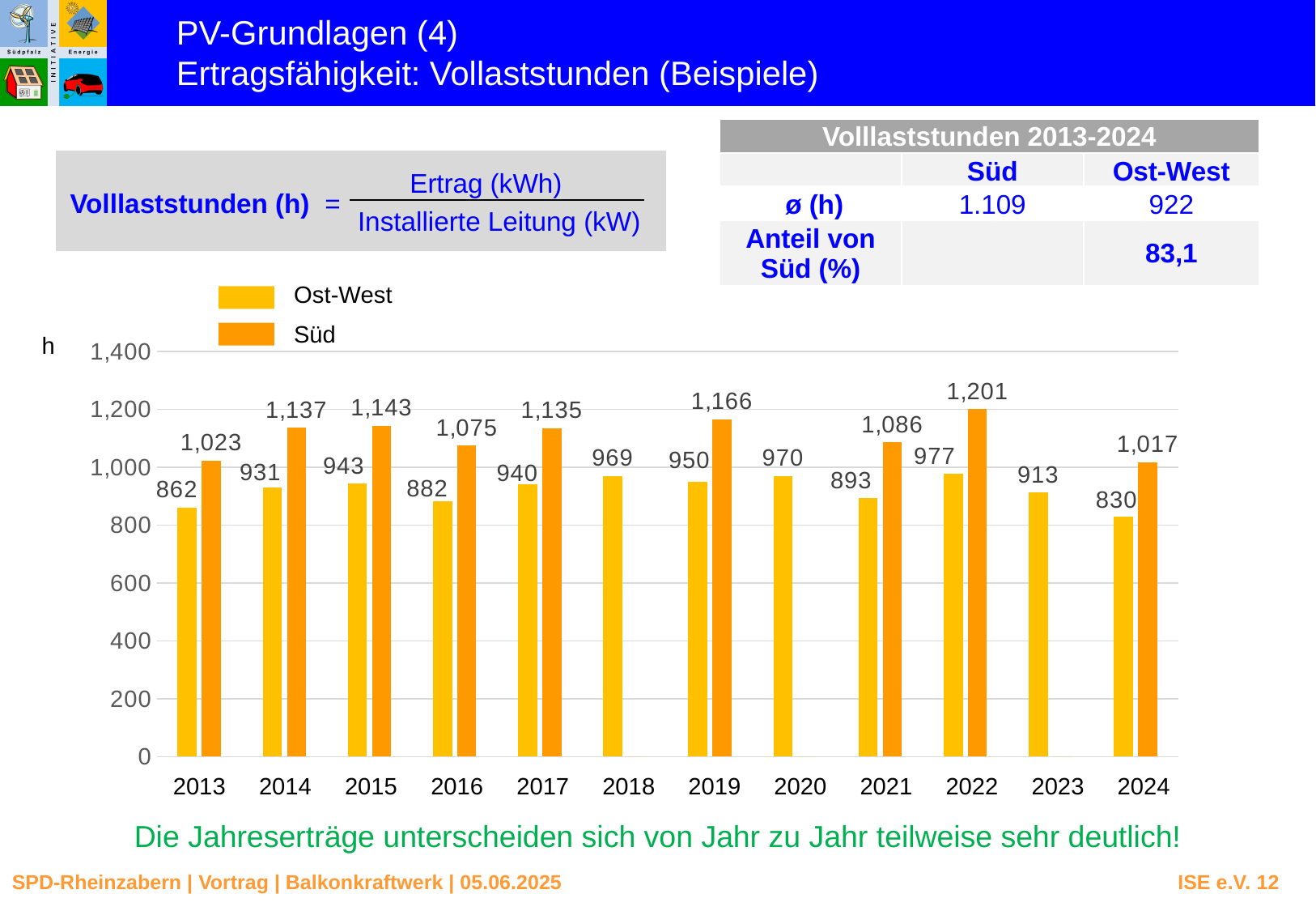
What kind of chart is shown on the slide? bar chart What is the Ost-West value for 2024? 830 Is the Süd value for 2016 greater or less than 1,000? greater Which year has the highest Süd value? 2022 Which colour represents the Süd series in the chart? orange What is the difference between the Süd and Ost-West values in 2019? 216 How many series does the legend list? 2 How many years are shown on the x axis? 12 What is the Süd value for 2022? 1,201 Which year has the lowest Ost-West value? 2024 Which is larger, the Ost-West value for 2020 or the Ost-West value for 2021? 2020 What is the Ost-West value for 2013? 862